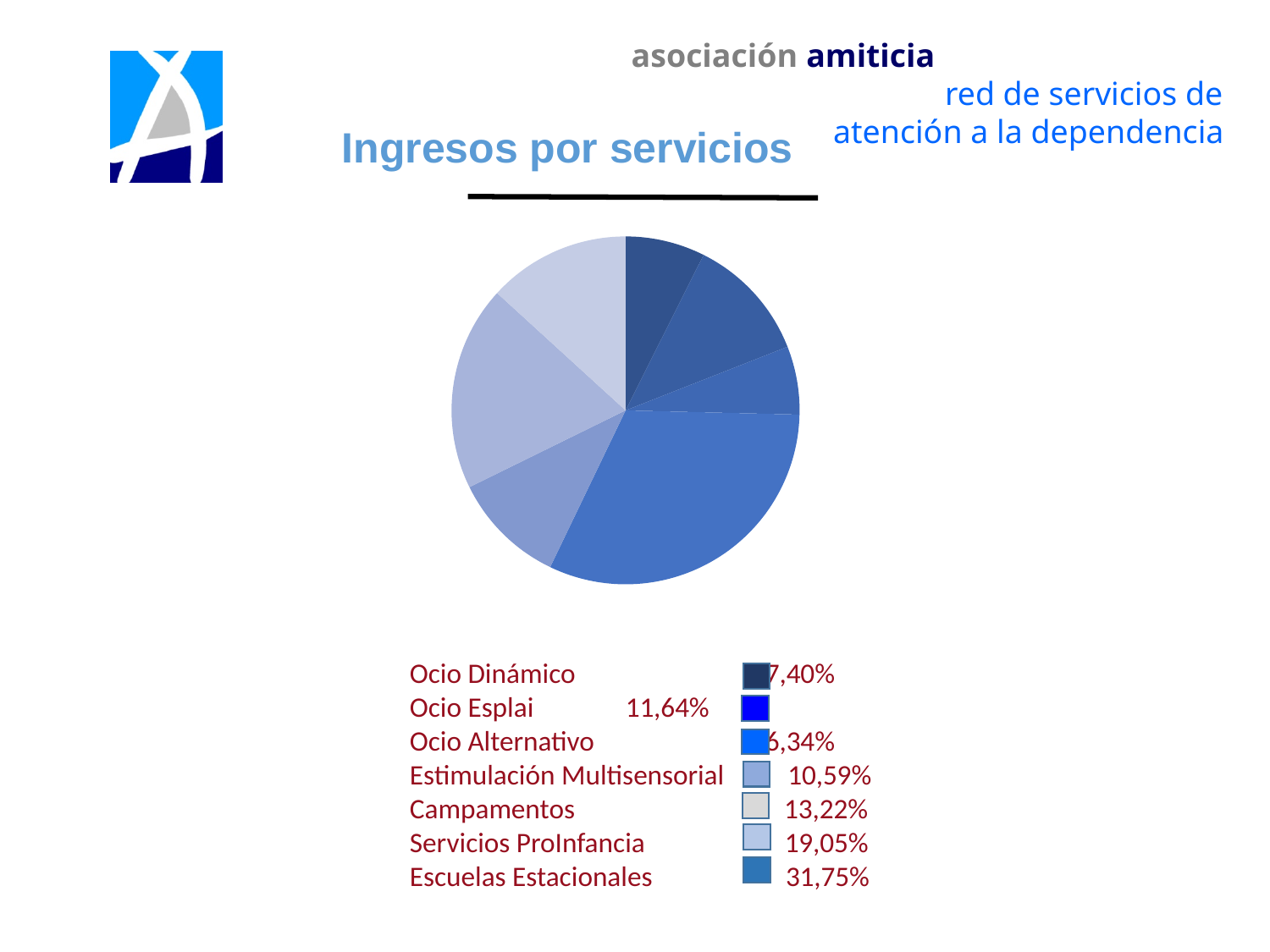
Which category has the largest share of the pie? Escuelas Estacionales What is the value for Estimulación Multisensorial? 10,59% What is the value for Servicios ProInfancia? 19,05% Which category has the smallest share of the pie? Ocio Alternativo What share of the pie does Escuelas Estacionales represent? 31,75% What is the value for Ocio Esplai? 11,64% What is the value for Campamentos? 13,22% What is the title of the chart? Ingresos por servicios How many categories does the pie chart have? 7 What kind of chart is shown on the slide? pie chart Which has a larger share, Campamentos or Ocio Esplai? Campamentos What is the difference between the shares of Escuelas Estacionales and Servicios ProInfancia? 12,70%